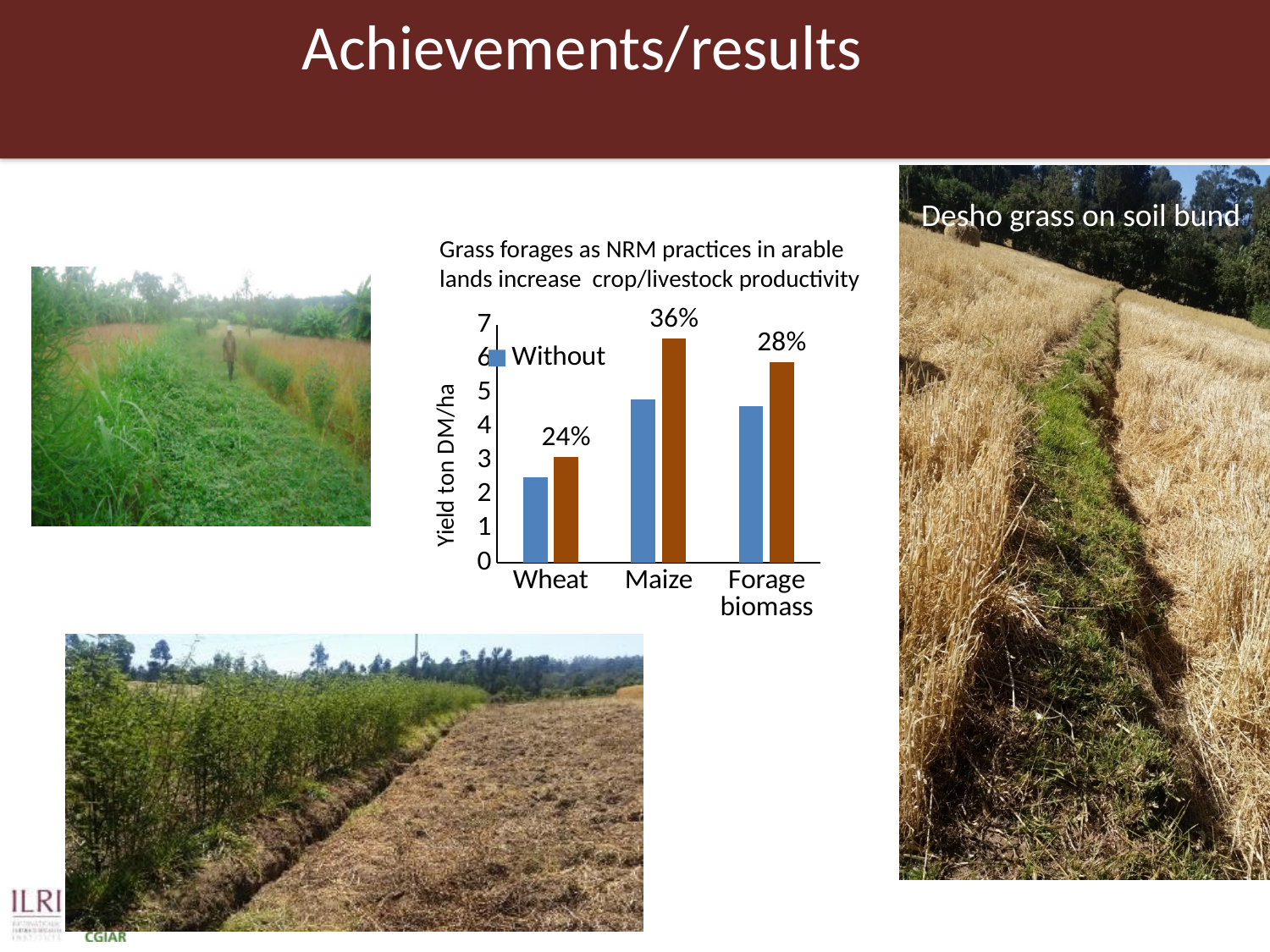
Which category has the taller brown bar, Maize or Wheat? Maize Which category has the highest percentage label? Maize What is the title of the y axis of the chart? Yield ton DM/ha Is the value of the taller (brown) bar for Maize greater or less than 6? greater What is the difference between the percentage labels for Maize and Wheat? 12% What kind of chart is shown on the slide? bar chart Which category has the lowest percentage label? Wheat What percentage label is shown above the Wheat bars? 24% What percentage label is shown above the Maize bars? 36% What percentage label is shown above the Forage biomass bars? 28% Is the value of the Without bar for Wheat greater or less than 3? less How many categories are shown on the x axis of the chart? 3